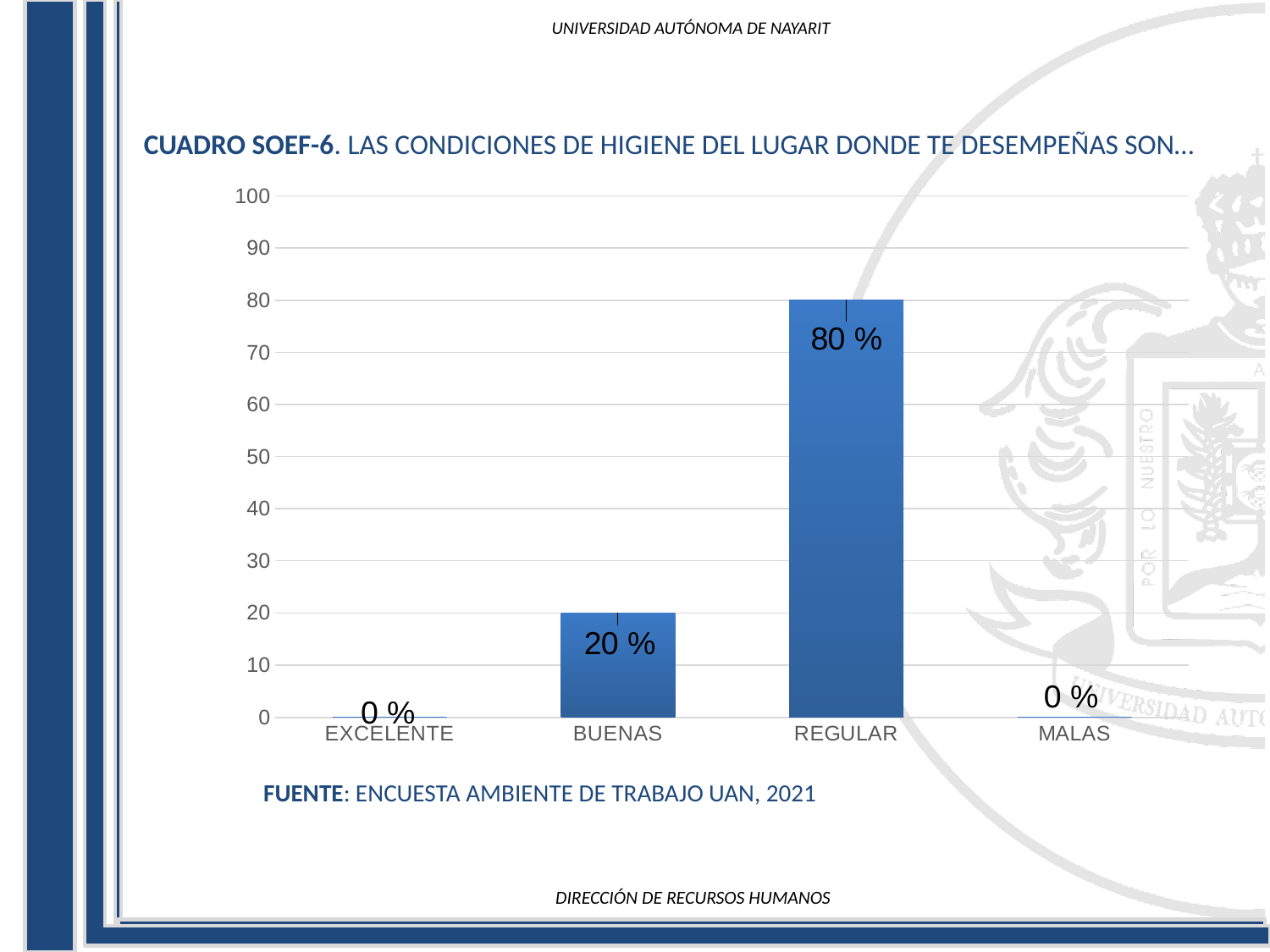
Which is larger, the value for BUENAS or the value for REGULAR? REGULAR What is the source cited below the chart? ENCUESTA AMBIENTE DE TRABAJO UAN, 2021 What is the value for MALAS? 0 % What is the value for EXCELENTE? 0 % What kind of chart is shown on the slide? bar chart Which category has the highest value? REGULAR What is the value for REGULAR? 80 % What is the title of the chart? CUADRO SOEF-6. LAS CONDICIONES DE HIGIENE DEL LUGAR DONDE TE DESEMPEÑAS SON… What is the value for BUENAS? 20 % How many categories are shown on the x axis? 4 Is the value for REGULAR greater or less than 50? greater What is the difference between the values for REGULAR and BUENAS? 60 %